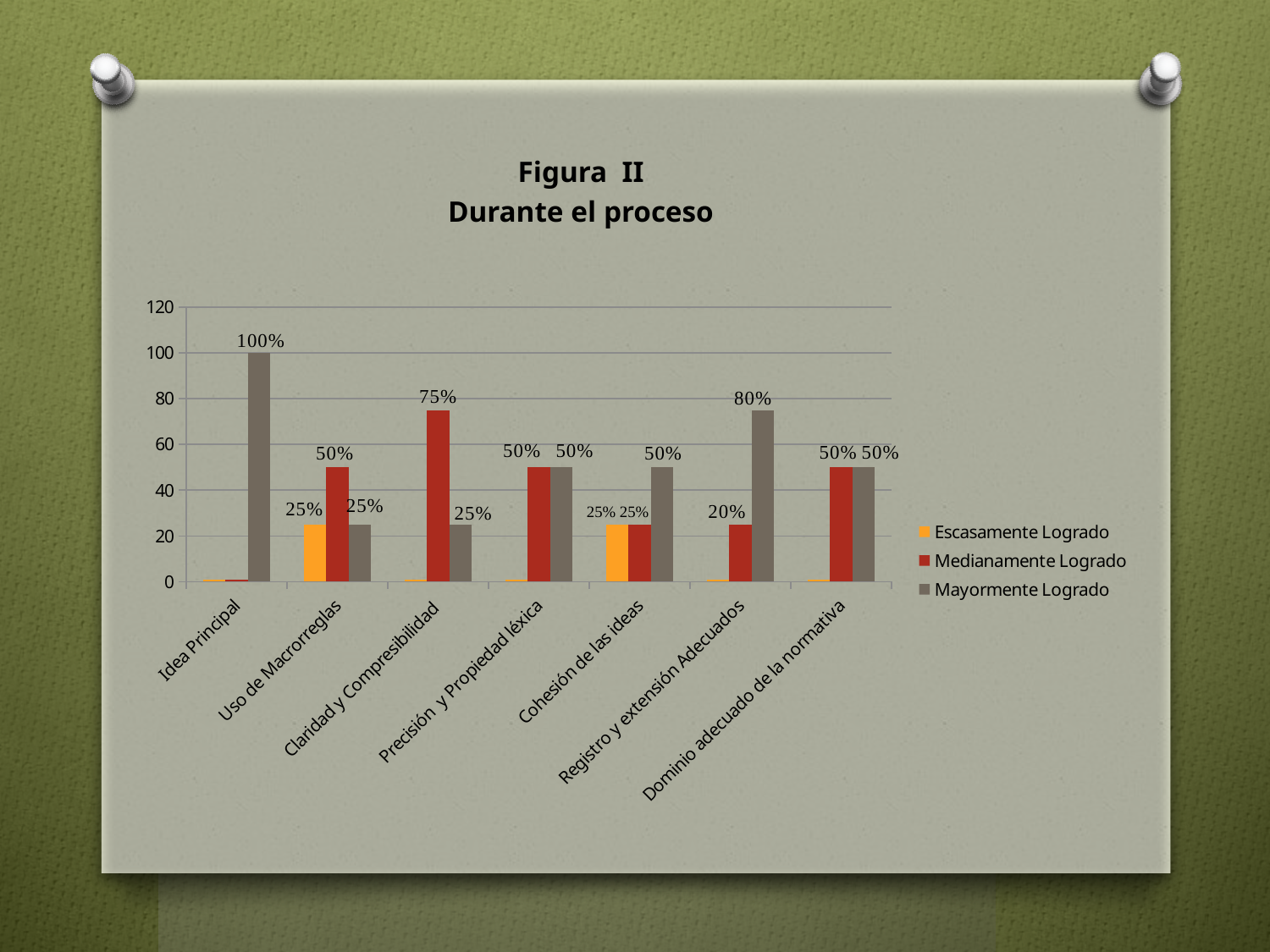
For Cohesión de las ideas, which is larger: Mayormente Logrado or Medianamente Logrado? Mayormente Logrado What is the value of Mayormente Logrado for Registro y extensión Adecuados? 80% Which category has the highest value for Medianamente Logrado? Claridad y Compresibilidad What is the difference between Medianamente Logrado and Mayormente Logrado for Claridad y Compresibilidad? 50% How many categories are shown on the x axis? 7 Which category has the highest value for Mayormente Logrado? Idea Principal What is the value of Escasamente Logrado for Uso de Macrorreglas? 25% What is the title of the chart? Figura II Durante el proceso What is the value of Mayormente Logrado for Idea Principal? 100% What is the value of Medianamente Logrado for Claridad y Compresibilidad? 75% How many series does the legend list? 3 What kind of chart is shown on the slide? Bar chart